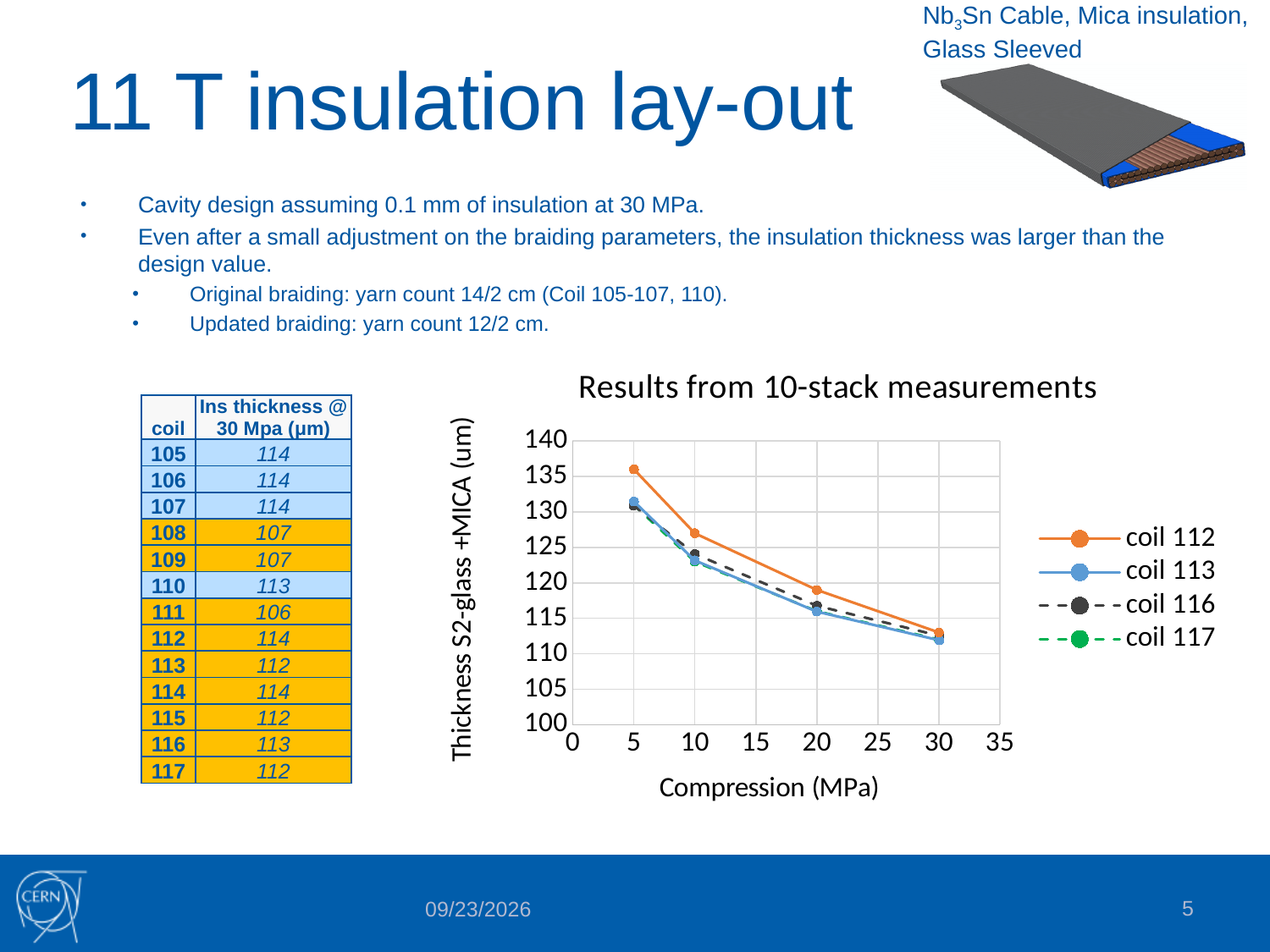
In the 'Results from 10-stack measurements' chart, is the value for coil 113 at 5 MPa greater or less than 125? greater How many series does the legend of the 'Results from 10-stack measurements' chart list? 4 How many compression points are plotted for each series in the 'Results from 10-stack measurements' chart? 4 In the 'Results from 10-stack measurements' chart, which is larger at 10 MPa: coil 112 or coil 113? coil 112 What kind of chart is 'Results from 10-stack measurements'? line chart In the 'Results from 10-stack measurements' chart, is the value for coil 112 at 20 MPa greater or less than 115? greater In the 'Results from 10-stack measurements' chart, is the value for coil 112 at 5 MPa greater or less than 130? greater In the 'Results from 10-stack measurements' chart, which series has the highest thickness at 5 MPa? coil 112 In the 'Results from 10-stack measurements' chart, does the thickness rise or fall as compression increases? fall What is the x-axis label of the 'Results from 10-stack measurements' chart? Compression (MPa) Which series in the 'Results from 10-stack measurements' chart is drawn in orange? coil 112